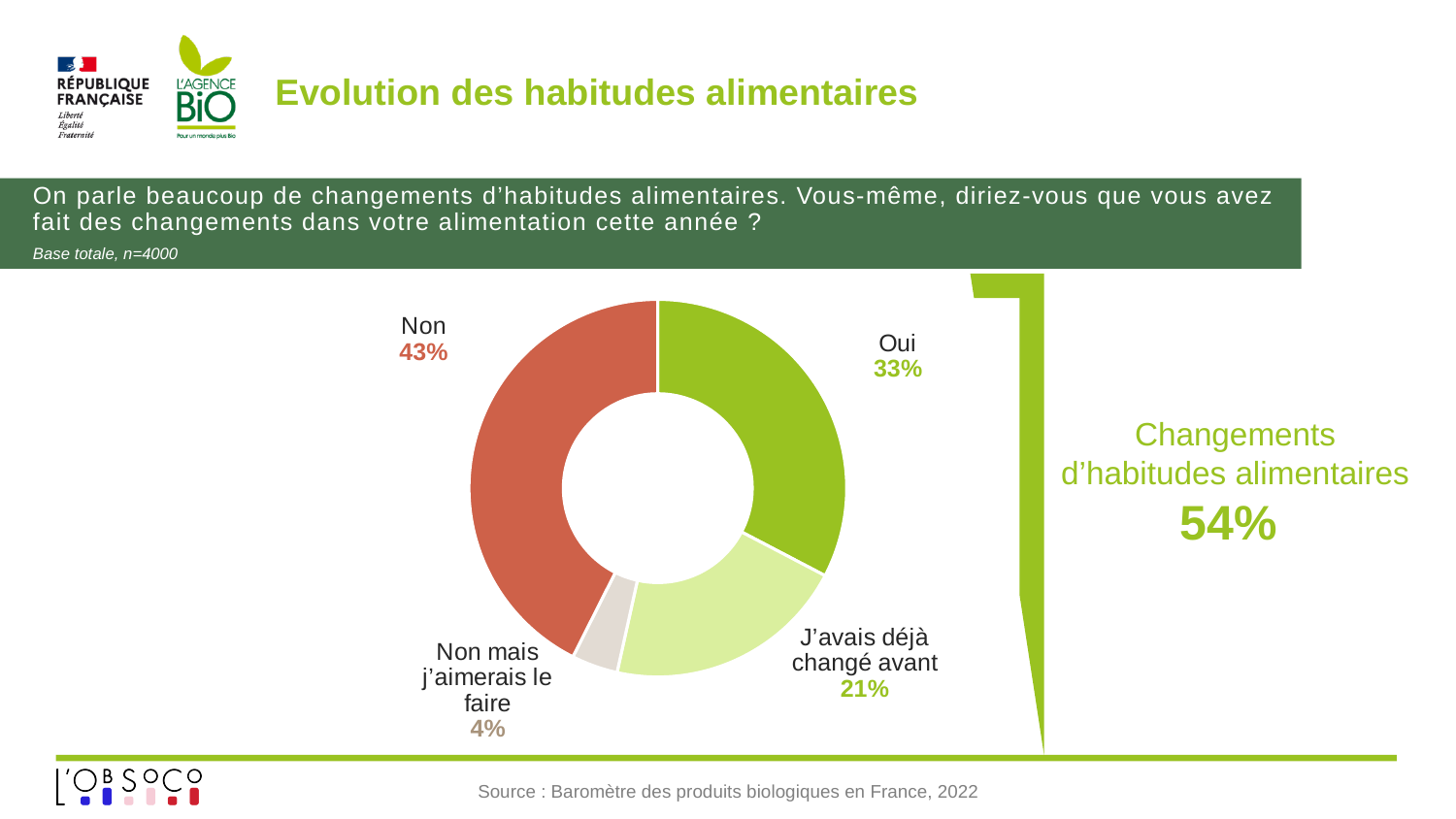
Which response category has the largest share of the chart? Non How many response categories are shown in the chart? 4 What combined percentage is given for "Changements d'habitudes alimentaires"? 54% What percentage of respondents answered "Oui"? 33% Which response category has the smallest share of the chart? Non mais j'aimerais le faire Which is larger, the share for "Oui" or the share for "J'avais déjà changé avant"? Oui What is the sample size (base) stated for the chart? n=4000 What percentage of respondents answered "Non mais j'aimerais le faire"? 4% What percentage of respondents answered "Non"? 43% What percentage of respondents answered "J'avais déjà changé avant"? 21% What kind of chart is shown on the slide? Doughnut chart What is the difference in percentage points between "Non" and "Oui"? 10